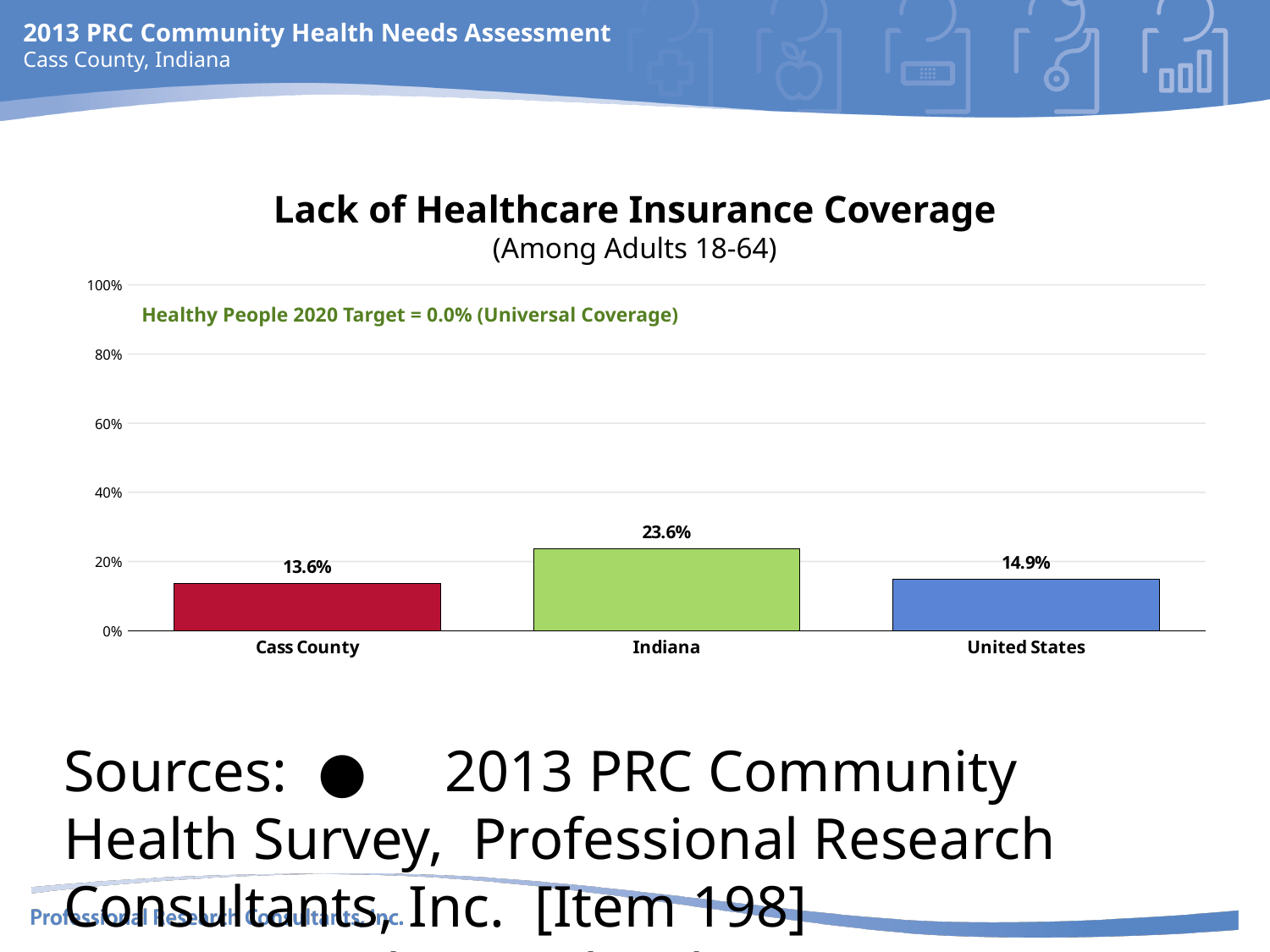
What kind of chart is shown on the slide? bar chart What is the Healthy People 2020 Target stated on the chart? 0.0% (Universal Coverage) How many categories are shown on the chart? 3 What is the value for Cass County? 13.6% Is the value for Indiana greater or less than 20%? greater What is the value for United States? 14.9% Which is larger, the value for Indiana or the value for United States? Indiana What is the value for Indiana? 23.6% Which category has the lowest value? Cass County What is the difference between the United States value and the Cass County value? 1.3% What is the difference between the Indiana value and the Cass County value? 10.0% Which category has the highest value? Indiana